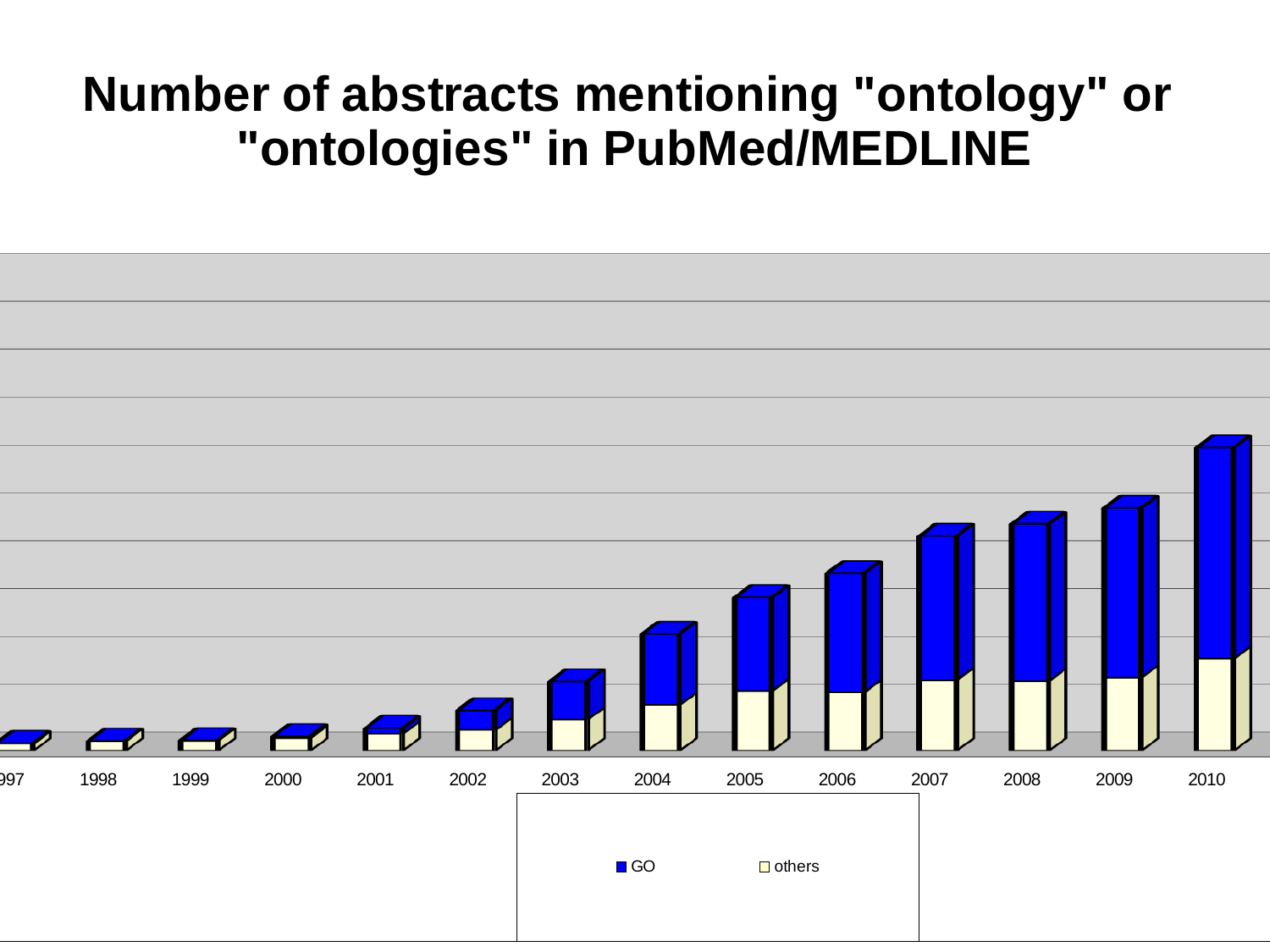
Which bar is taller, 2003 or 2007? 2007 What is the last year shown on the x axis? 2010 Do the bar heights generally rise or fall from 1997 to 2010? Rise Which bar is taller, 2005 or 2010? 2010 In 2010, which segment is larger, GO or others? GO Which year has the tallest bar? 2010 Which series is shown in blue? GO How many years are shown along the x axis? 14 What kind of chart is shown on the slide? Stacked bar chart What are the two series named in the legend? GO and others How many series does the legend list? 2